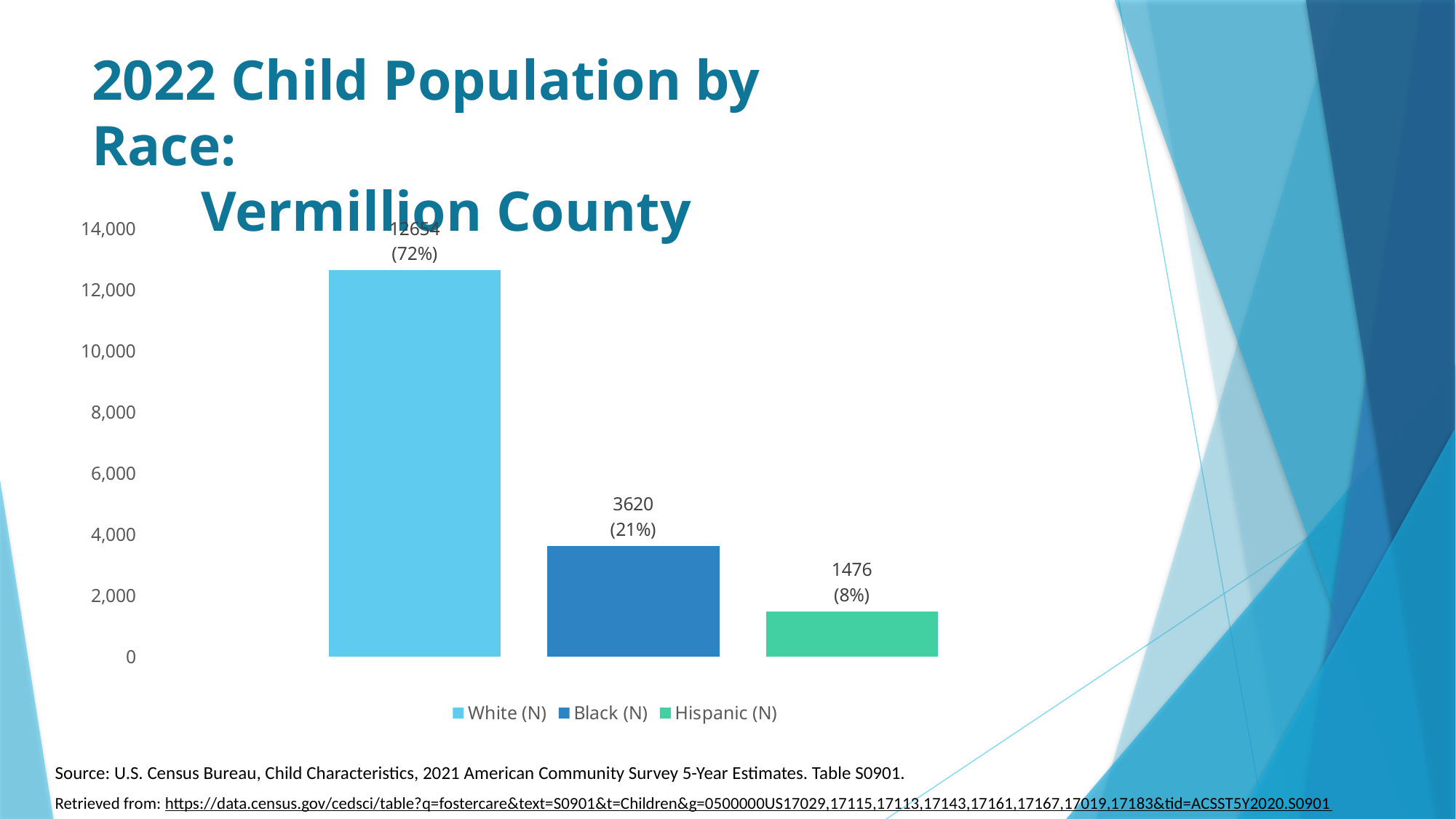
What is the value for Black (N)? 3620 What percentage is shown for White (N)? 72% What percentage is shown for Black (N)? 21% Is the value for White (N) greater or less than 12,000? greater What is the difference between the values for Black (N) and Hispanic (N)? 2144 Which category has the lowest value? Hispanic (N) Which category has the highest value? White (N) Which is larger, the value for Black (N) or the value for Hispanic (N)? Black (N) What is the value for Hispanic (N)? 1476 What kind of chart is shown on the slide? bar chart What percentage is shown for Hispanic (N)? 8% How many bars are plotted on the chart? 3